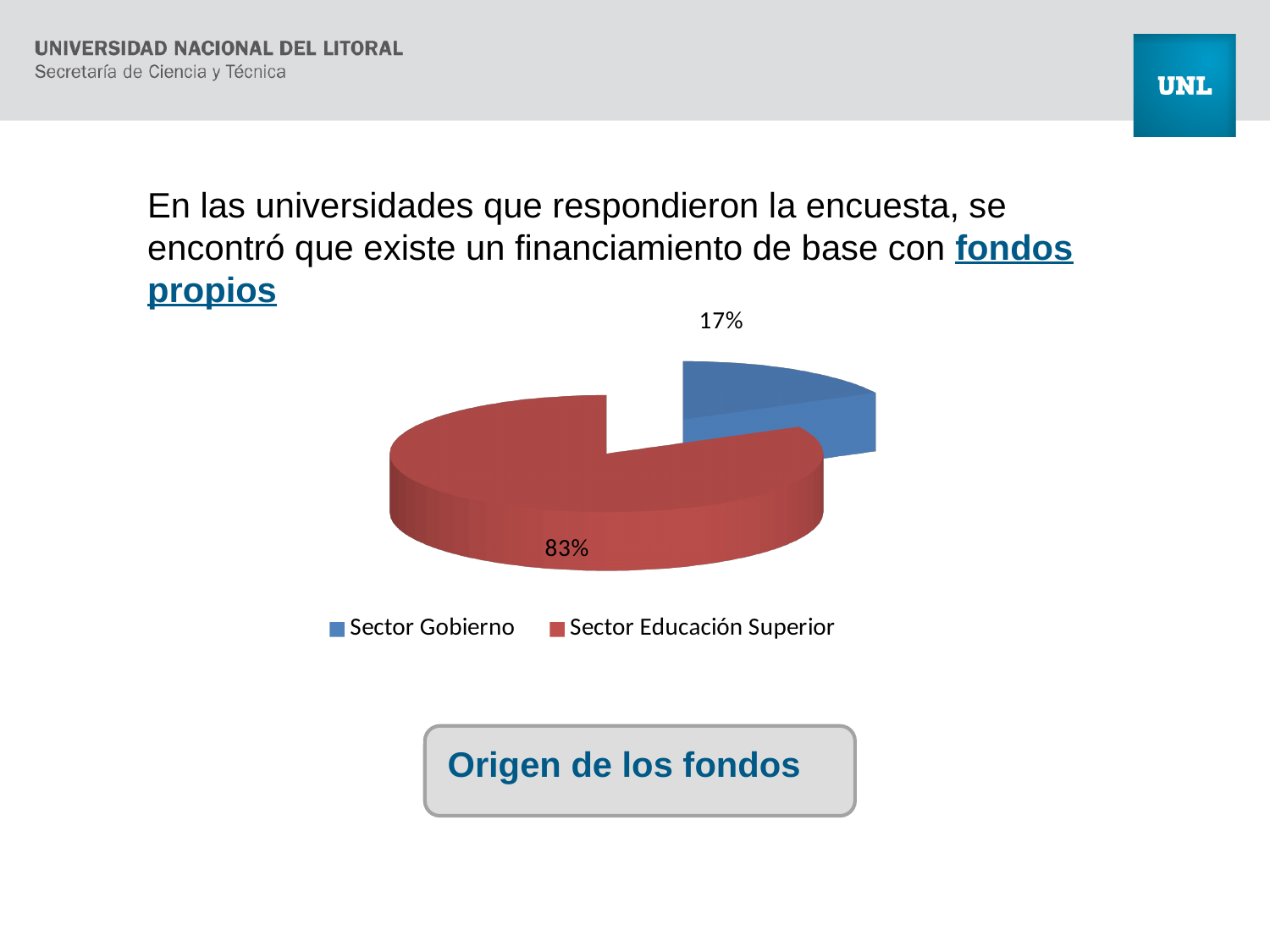
Which is larger, the slice for Sector Gobierno or the slice for Sector Educación Superior? Sector Educación Superior How many entries does the legend list? 2 What kind of chart is shown on the slide? Pie chart What is the difference in percentage points between Sector Educación Superior and Sector Gobierno? 66 What colour is the slice for Sector Educación Superior? Red What colour is the slice for Sector Gobierno? Blue How many categories does the pie chart show? 2 Which category has the smallest slice of the pie? Sector Gobierno Which category has the largest slice of the pie? Sector Educación Superior What share of the pie does Sector Educación Superior represent? 83% What share of the pie does Sector Gobierno represent? 17%